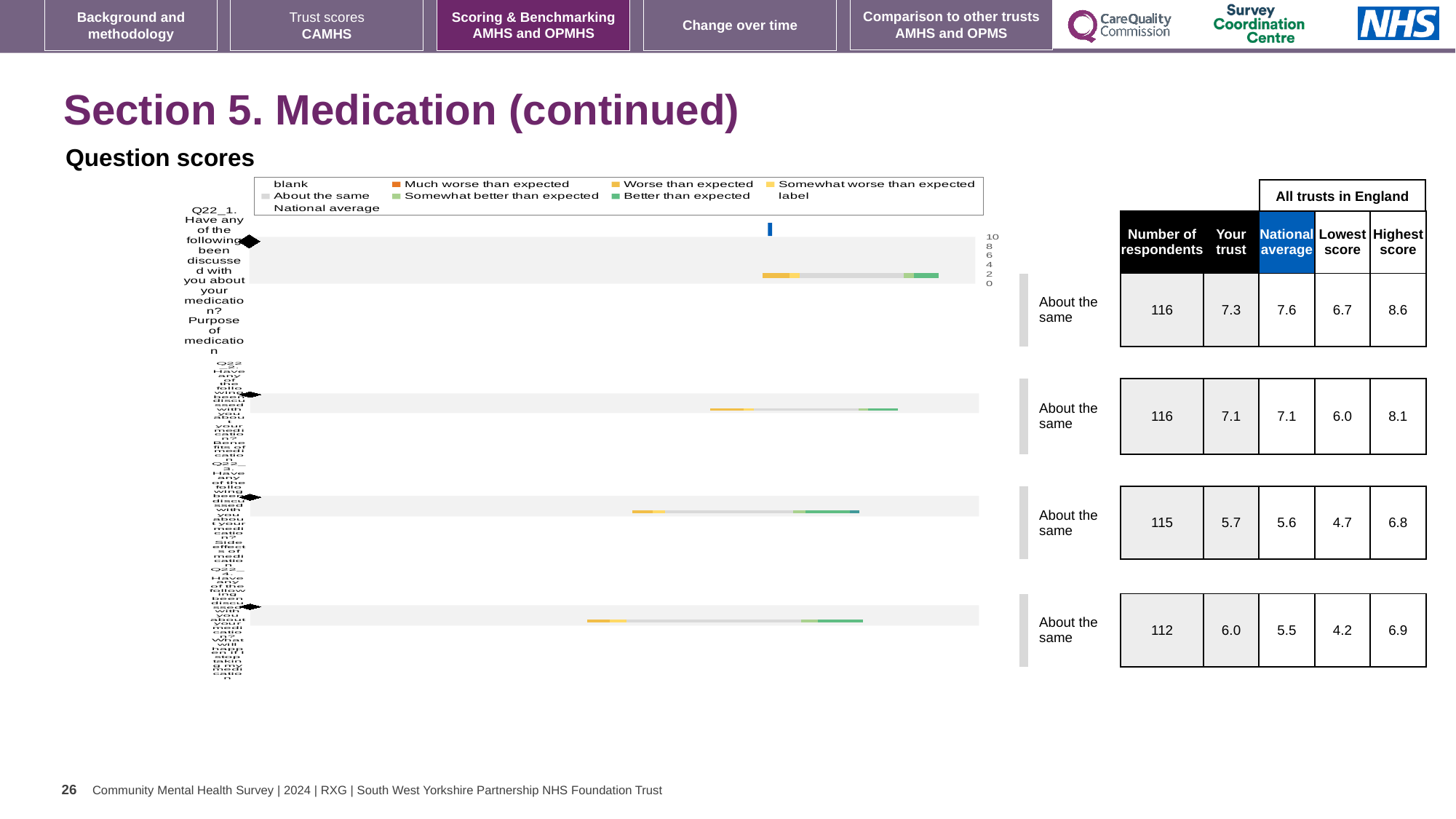
What colour does the legend use for 'Much worse than expected'? orange For the bottom row, which is larger: the 'Your trust' score or the national average? Your trust (6.0) What is the highest tick value shown on the chart's score axis? 10 What kind of chart is shown under 'Question scores'? bar chart How many question rows (bars) are plotted in the chart? 4 What is the national average for the third row of the table? 5.6 For the top row (Q22_1), what is the difference between the highest score and the lowest score? 1.9 What is the 'Your trust' score for the top row (Q22_1, purpose of medication)? 7.3 How many entries does the chart legend list? 9 Which row has the lowest 'Your trust' score? the third row, 5.7 Which row has the highest 'Your trust' score? the top row (Q22_1), 7.3 How many respondents are listed for the top row (Q22_1)? 116